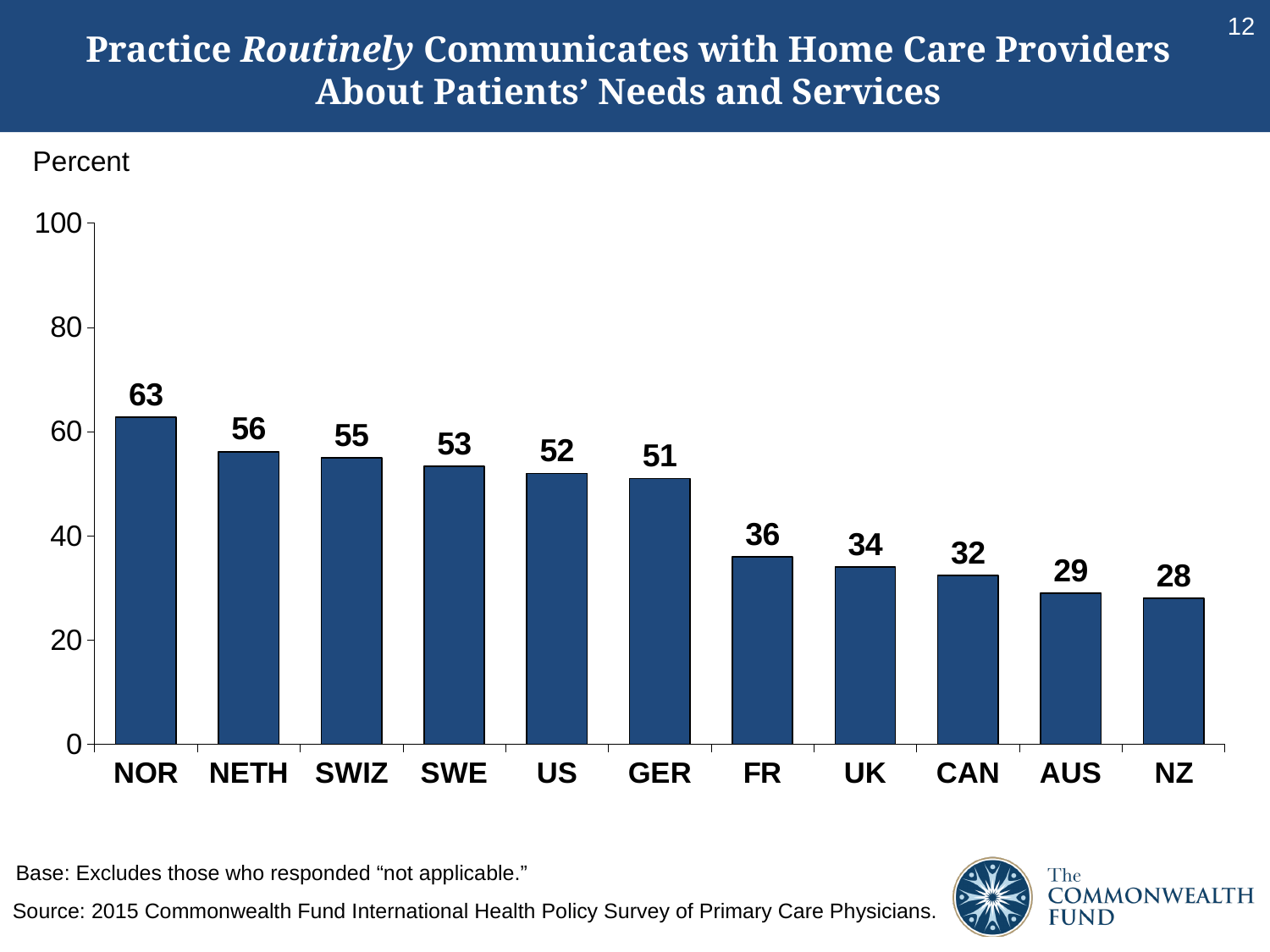
What is the value for NOR? 63 Which is larger, the value for FR or the value for AUS? FR Do the values rise or fall from left to right along the x axis? fall What kind of chart is shown on the slide? bar chart What is the value for GER? 51 Which country has the highest value? NOR What is the difference between the values for US and UK? 18 What is the difference between the values for NOR and NZ? 35 Is the value for SWE greater or less than 40? greater What is the value for CAN? 32 Which country has the lowest value? NZ How many countries are shown on the chart? 11